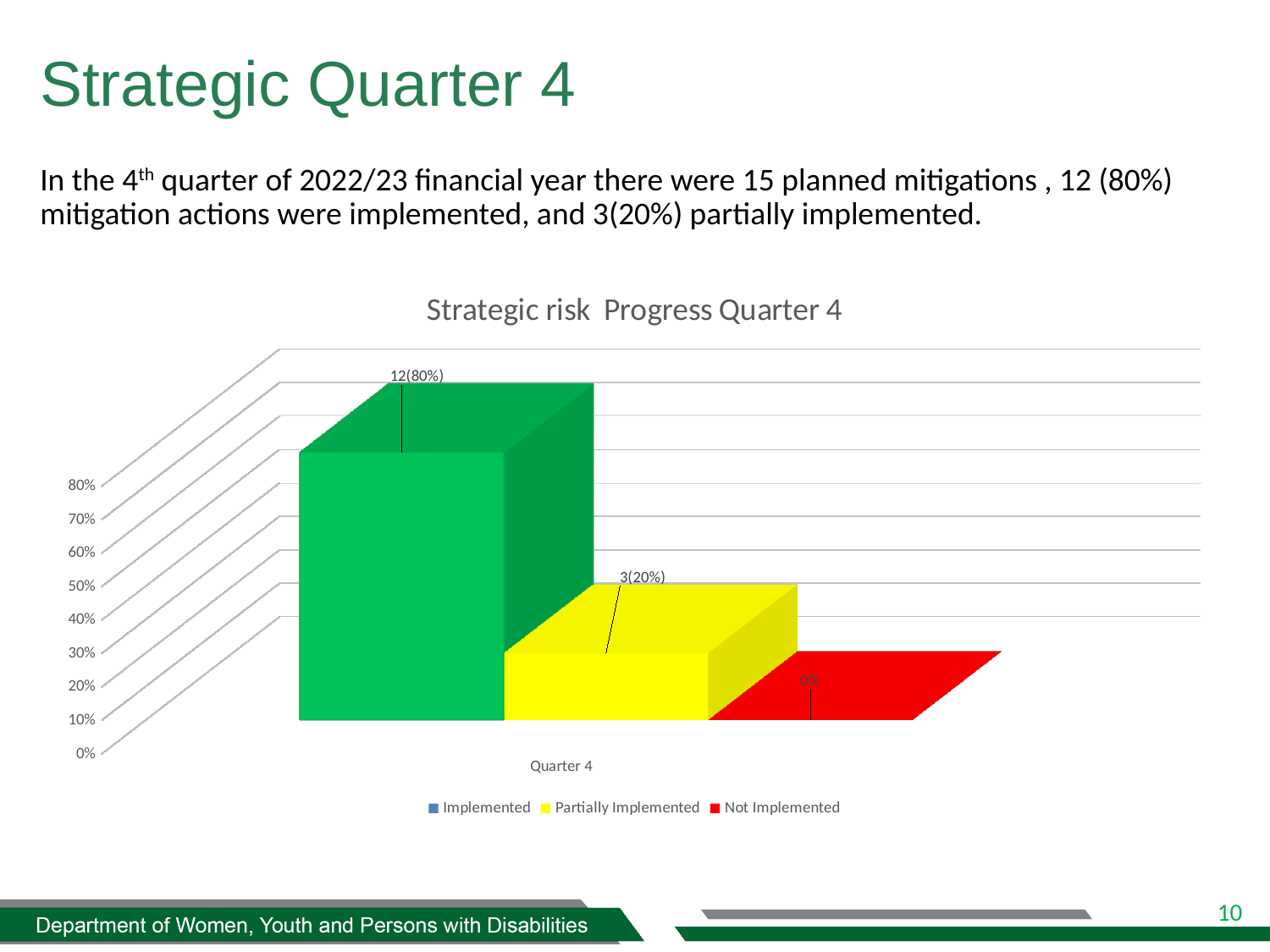
What is the category label shown on the x axis? Quarter 4 What is the data label shown for the Not Implemented series? 0% Is the value for Partially Implemented greater or less than 50%? less Which is larger, the value for Implemented or the value for Partially Implemented? Implemented What is the data label shown for the Implemented series? 12(80%) How many series does the legend list? 3 Which series has the highest value in the chart? Implemented What is the title of the chart? Strategic risk Progress Quarter 4 Which series has the lowest value in the chart? Not Implemented What type of chart is shown on the slide? bar chart How many categories are shown on the x axis? 1 What is the data label shown for the Partially Implemented series? 3(20%)